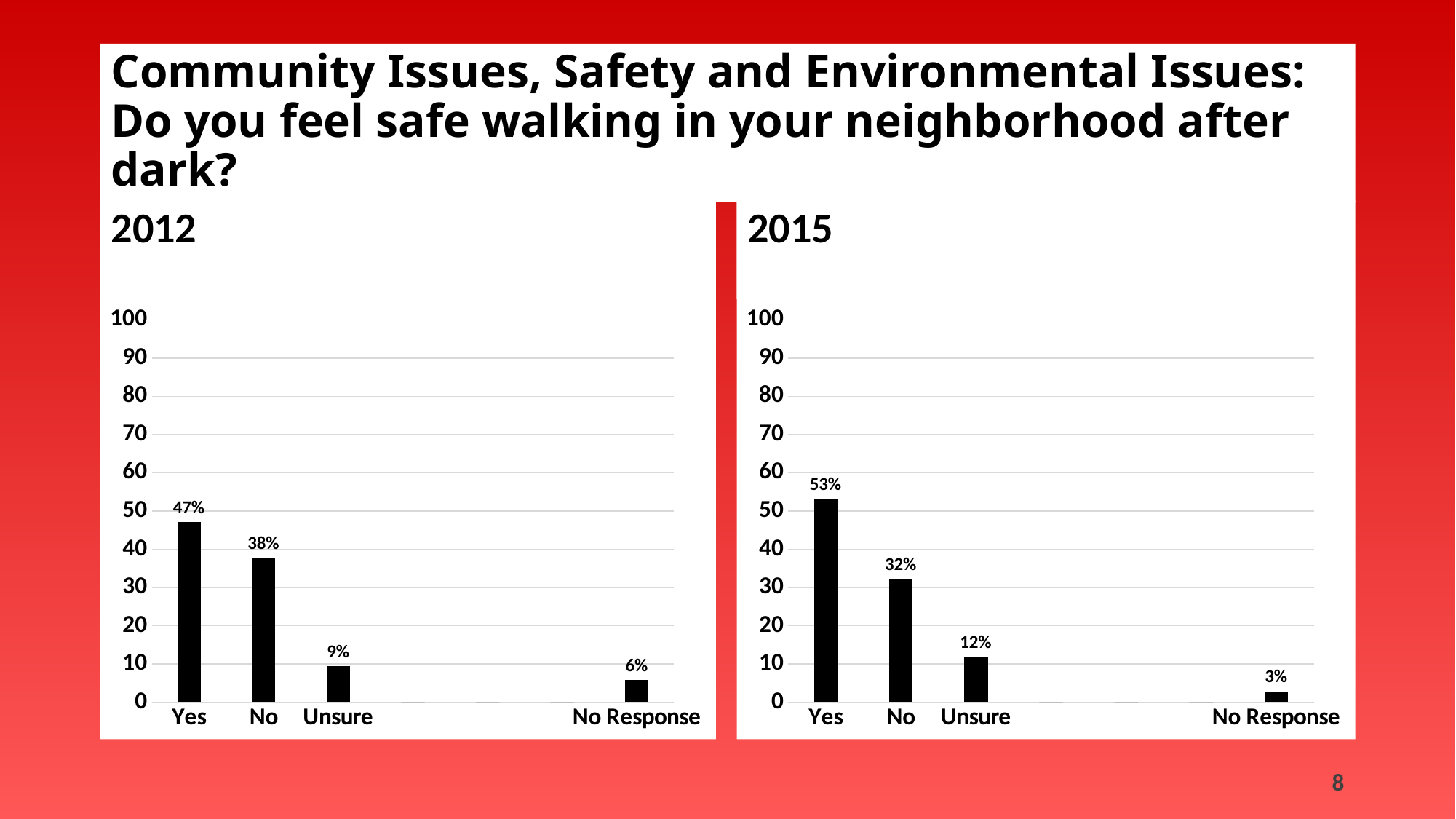
In the 2015 chart, is the value for No greater or less than 40? less In the 2015 chart, what is the value for No? 32% In the 2012 chart, which category has the lowest value? No Response In the 2015 chart, which category has the highest value? Yes In the 2012 chart, what is the value for Yes? 47% In the 2012 chart, what is the difference between the values for Yes and No? 9% In the 2015 chart, what is the difference between the values for Yes and Unsure? 41% What type of chart is the 2015 chart? Bar chart Which is larger: the value for Yes in the 2012 chart or the value for Yes in the 2015 chart? 2015 In the 2012 chart, how many labelled categories are shown on the x axis? 4 In the 2012 chart, what is the value for Unsure? 9% In the 2015 chart, what is the value for No Response? 3%